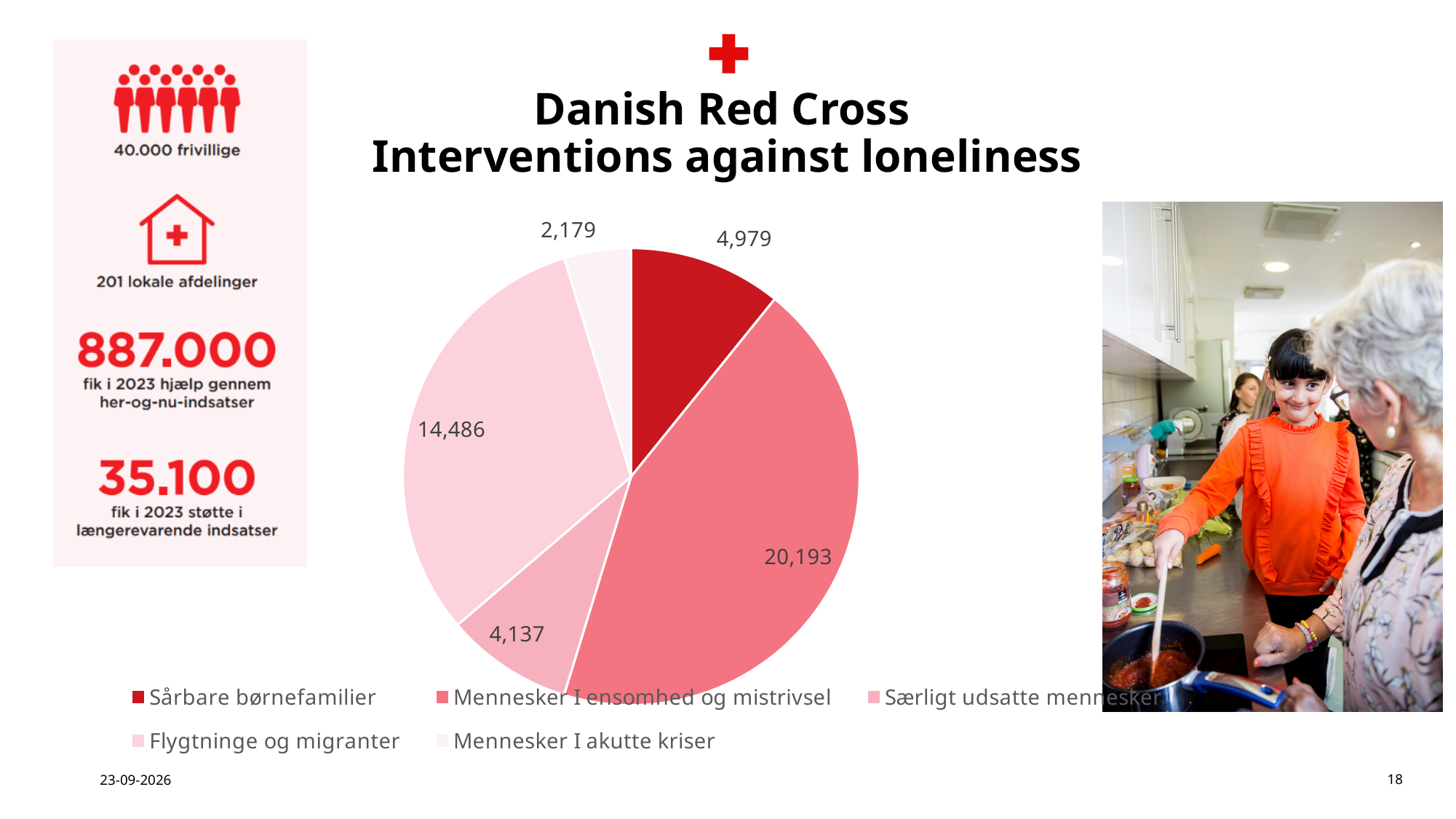
What kind of chart is shown on the slide? Pie chart How many slices does the pie chart have? 5 What is the total of all the values shown in the pie chart? 45,974 Which category has the smallest slice of the pie? Mennesker I akutte kriser What is the value for Mennesker I ensomhed og mistrivsel? 20,193 Which is larger, the value for Sårbare børnefamilier or the value for Særligt udsatte mennesker? Sårbare børnefamilier What is the difference between the values for Mennesker I ensomhed og mistrivsel and Flygtninge og migranter? 5,707 What is the value for Sårbare børnefamilier? 4,979 How many entries does the legend of the pie chart list? 5 What is the value for Mennesker I akutte kriser? 2,179 What is the value for Flygtninge og migranter? 14,486 Which category has the largest slice of the pie? Mennesker I ensomhed og mistrivsel